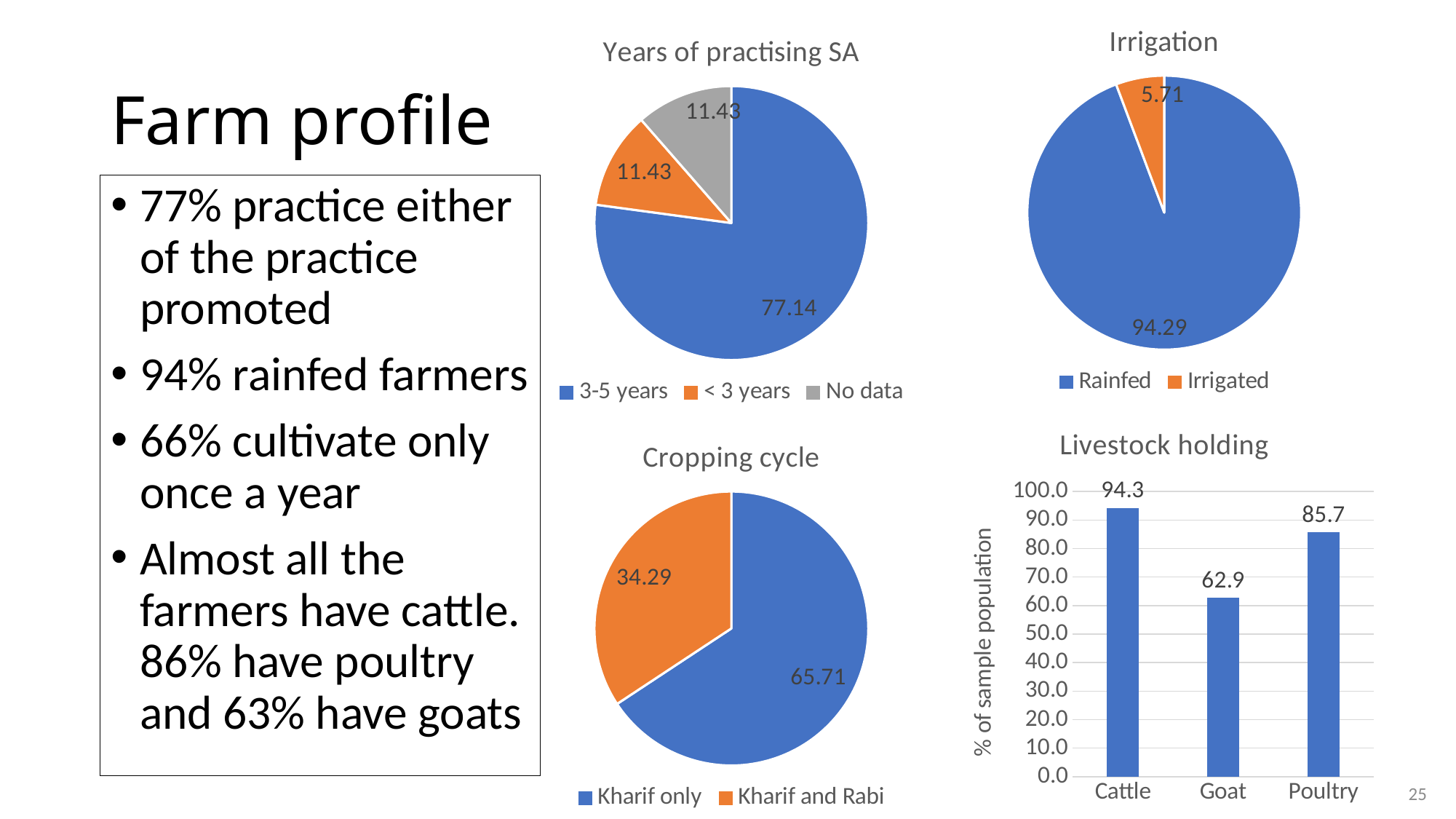
In the 'Livestock holding' bar chart, which category has the lowest value? Goat In the 'Livestock holding' bar chart, how many categories are shown? 3 In the 'Years of practising SA' pie chart, what is the value for '3-5 years'? 77.14 In the 'Years of practising SA' pie chart, what is the value for '< 3 years'? 11.43 In the 'Irrigation' pie chart, what is the value for 'Irrigated'? 5.71 In the 'Cropping cycle' pie chart, what is the value for 'Kharif and Rabi'? 34.29 How many entries does the legend of the 'Years of practising SA' chart list? 3 In the 'Irrigation' pie chart, which category is the largest? Rainfed In the 'Livestock holding' bar chart, what is the difference between Cattle and Poultry? 8.6 In the 'Livestock holding' bar chart, what is the value for Goat? 62.9 What type of chart is 'Livestock holding'? Bar chart In the 'Cropping cycle' pie chart, what is the difference between 'Kharif only' and 'Kharif and Rabi'? 31.42